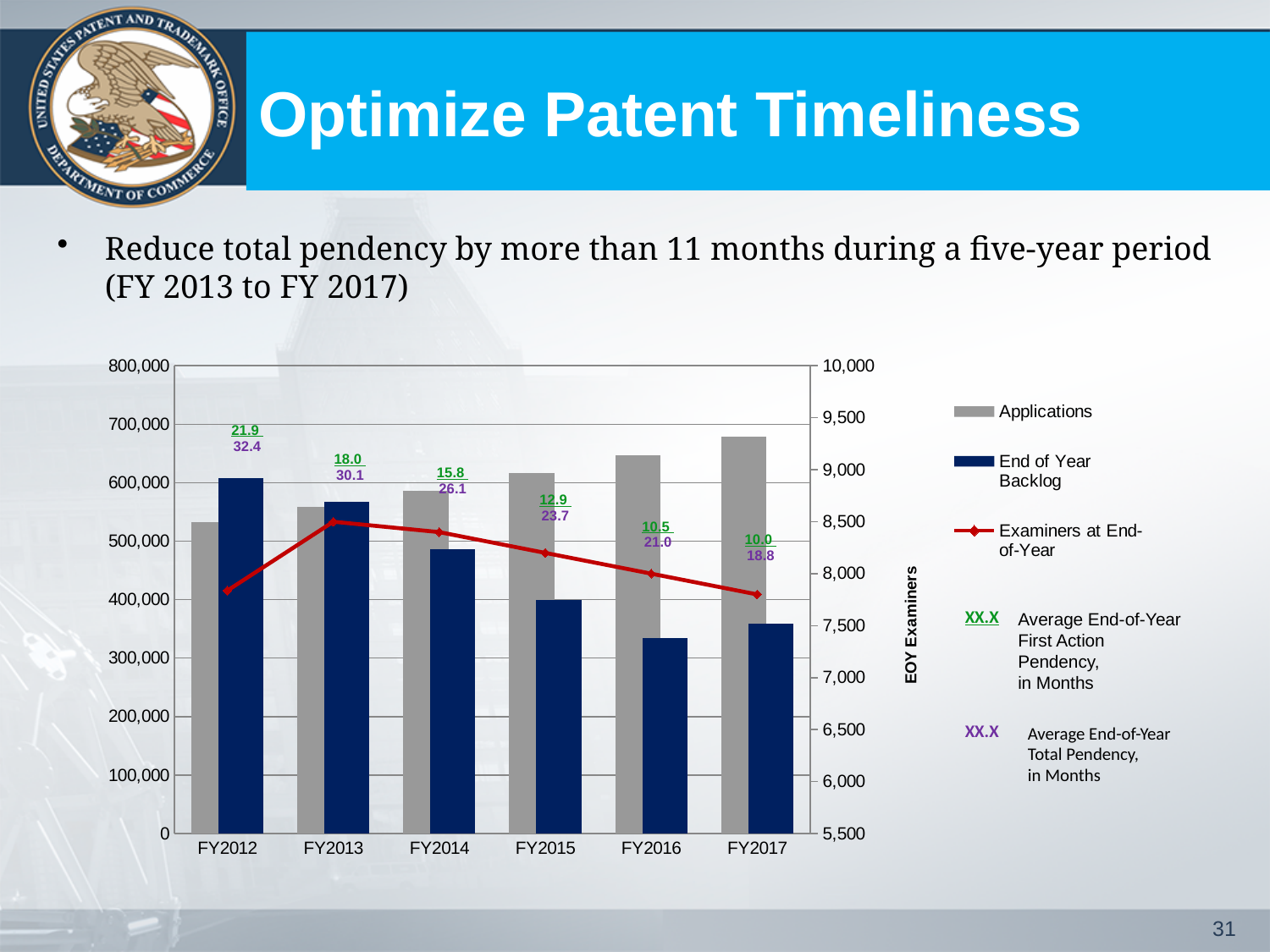
In which fiscal year does the Examiners at End-of-Year line reach its highest point? FY2013 Is the Examiners at End-of-Year value for FY2013 greater or less than 8,000? greater Which fiscal year has the lowest End of Year Backlog bar? FY2016 Does the Average End-of-Year First Action Pendency rise or fall from FY2012 to FY2017? fall Is the End of Year Backlog value for FY2016 greater or less than 400,000? less Is the Applications value for FY2012 greater or less than 600,000? less What is the Average End-of-Year Total Pendency in months shown for FY2014? 26.1 Which fiscal year has the highest Applications bar? FY2017 How many fiscal years are shown on the x axis of the chart? 6 What is the Average End-of-Year First Action Pendency in months shown for FY2012? 21.9 By how many months does the Average End-of-Year Total Pendency fall from FY2012 to FY2017? 13.6 What is the Average End-of-Year Total Pendency in months shown for FY2017? 18.8